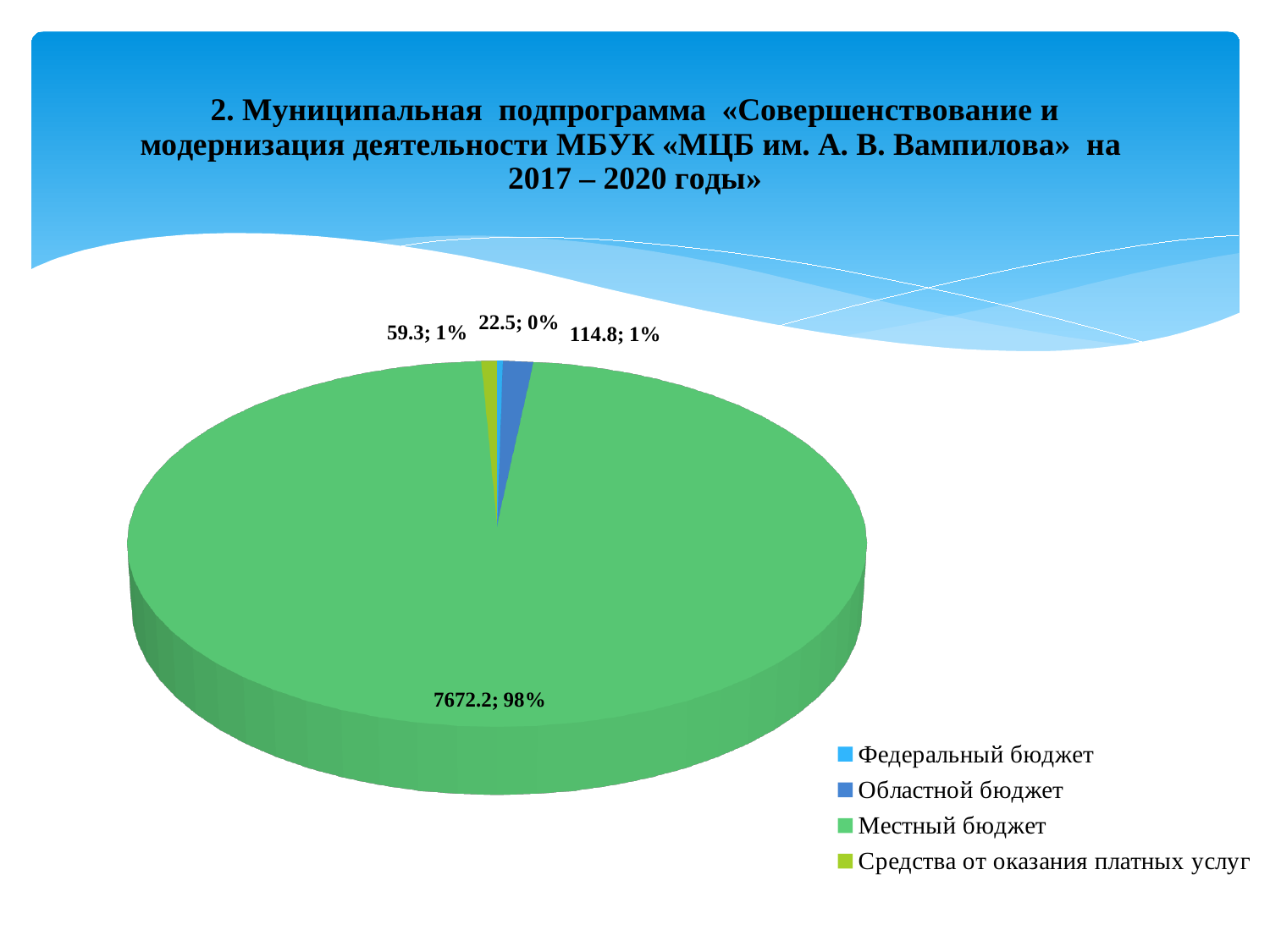
Which category has the largest slice of the pie? Местный бюджет How many entries does the legend of the pie chart list? 4 What is the value shown for Федеральный бюджет? 22.5 What kind of chart is shown on the slide? pie chart How many slices does the pie chart have? 4 Which is larger, the value for Областной бюджет or the value for Федеральный бюджет? Областной бюджет What is the value shown for Областной бюджет? 114.8 What is the difference between the values for Областной бюджет and Средства от оказания платных услуг? 55.5 Which category has the smallest slice of the pie? Федеральный бюджет What percentage share of the pie does Местный бюджет have? 98% What is the value shown for Средства от оказания платных услуг? 59.3 What is the value shown for Местный бюджет? 7672.2